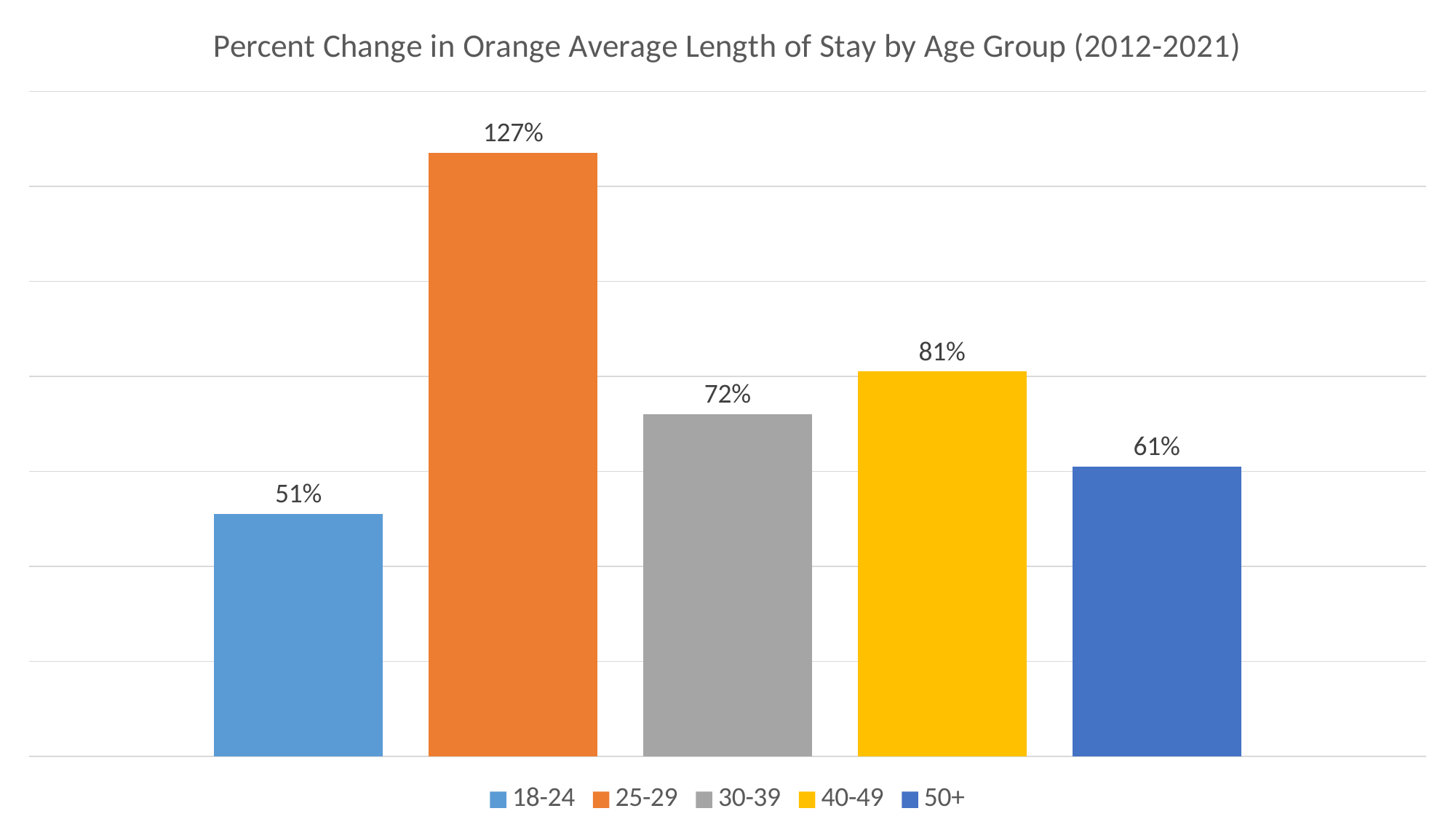
What is the percent change in average length of stay for the 50+ age group? 61% Which age group has the lowest percent change in average length of stay? 18-24 How many age groups are shown in the chart? 5 What is the percent change in average length of stay for the 25-29 age group? 127% What is the title of the chart? Percent Change in Orange Average Length of Stay by Age Group (2012-2021) How many entries does the legend list? 5 What is the percent change in average length of stay for the 18-24 age group? 51% What is the difference between the percent change for the 40-49 group and the 50+ group? 20% Which has a larger percent change, the 30-39 group or the 40-49 group? 40-49 Which age group has the highest percent change in average length of stay? 25-29 What kind of chart is shown on the slide? Bar chart What is the difference between the percent change for the 25-29 group and the 30-39 group? 55%